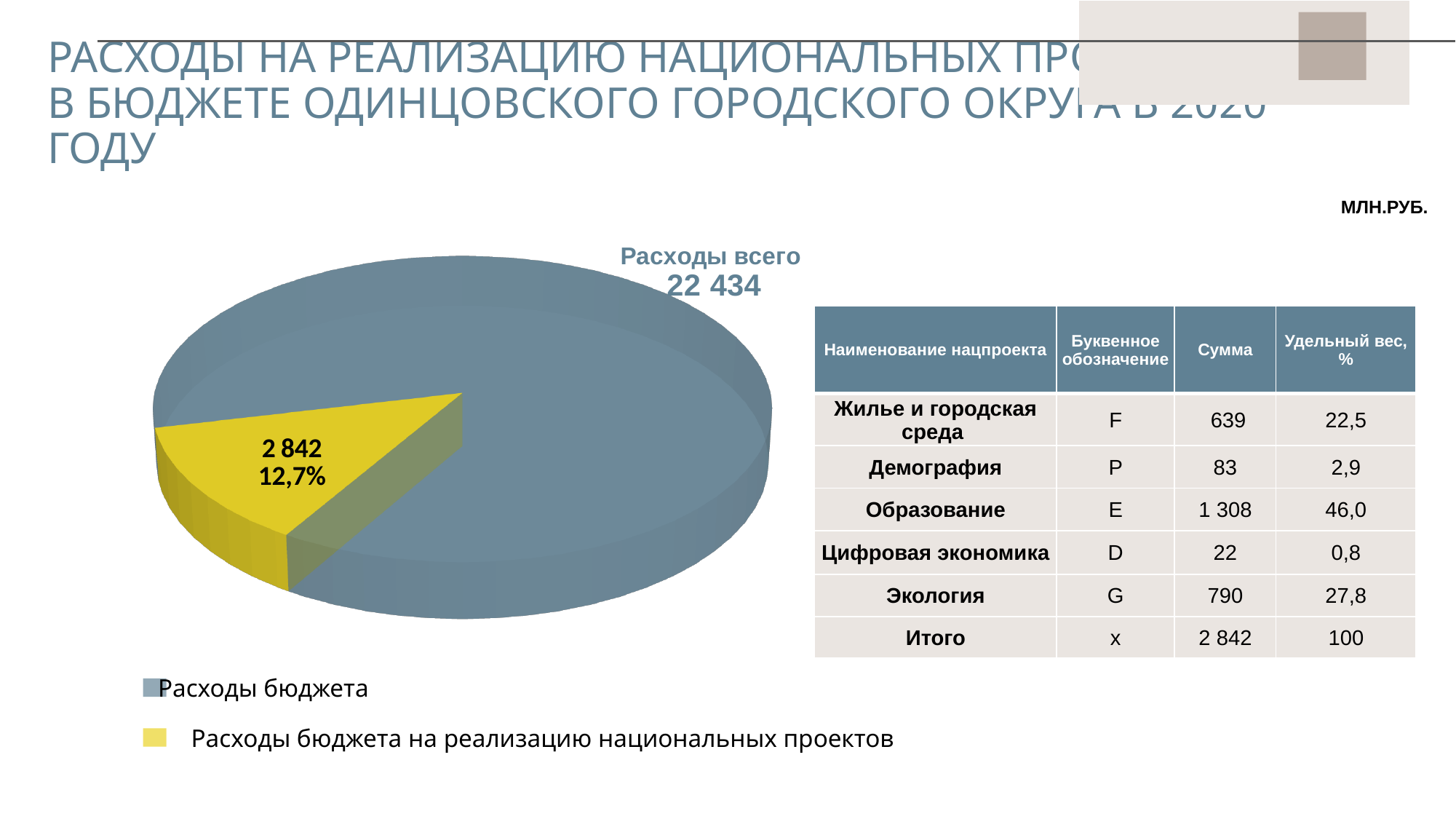
Which slice of the pie chart is the largest? Расходы бюджета In what units are the values on the slide expressed, according to the label in the top right? МЛН.РУБ. How many slices does the pie chart have? 2 What kind of chart is shown on the slide? pie chart What share of the pie does the slice for 'Расходы бюджета на реализацию национальных проектов' represent? 12,7% Which is larger in the pie chart: 'Расходы бюджета' or 'Расходы бюджета на реализацию национальных проектов'? Расходы бюджета How many entries does the legend of the pie chart list? 2 What is the difference between 'Расходы всего' (22 434) and the value of the national projects slice (2 842)? 19 592 Which slice of the pie chart is the smallest? Расходы бюджета на реализацию национальных проектов What is the value shown for 'Расходы всего' on the pie chart? 22 434 What colour is the slice for 'Расходы бюджета на реализацию национальных проектов' in the pie chart? yellow What value is labelled on the yellow slice of the pie chart? 2 842